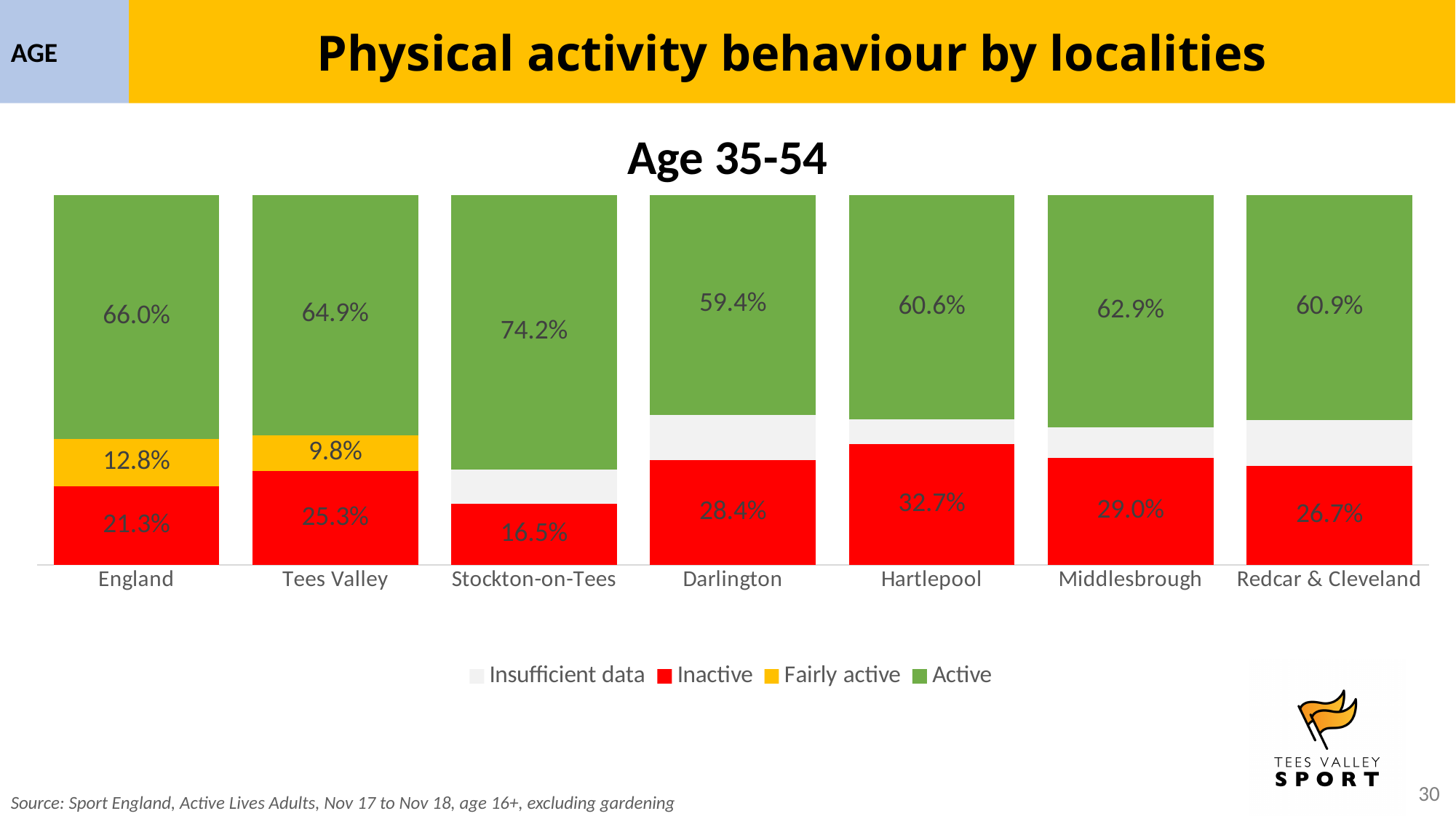
Which locality has the lowest Active value? Darlington What kind of chart is shown on the slide? Stacked bar chart How many series does the legend list? 4 What is the Inactive value for Hartlepool? 32.7% Which locality has the lowest Inactive value? Stockton-on-Tees What is the difference between the Inactive values for Hartlepool and England? 11.4% Which locality has the highest Active value? Stockton-on-Tees Which has a higher Active value, Middlesbrough or Redcar & Cleveland? Middlesbrough How many localities are shown on the x axis? 7 What is the Fairly active value for England? 12.8% Which colour represents the Inactive series? Red What is the Active value for Stockton-on-Tees? 74.2%